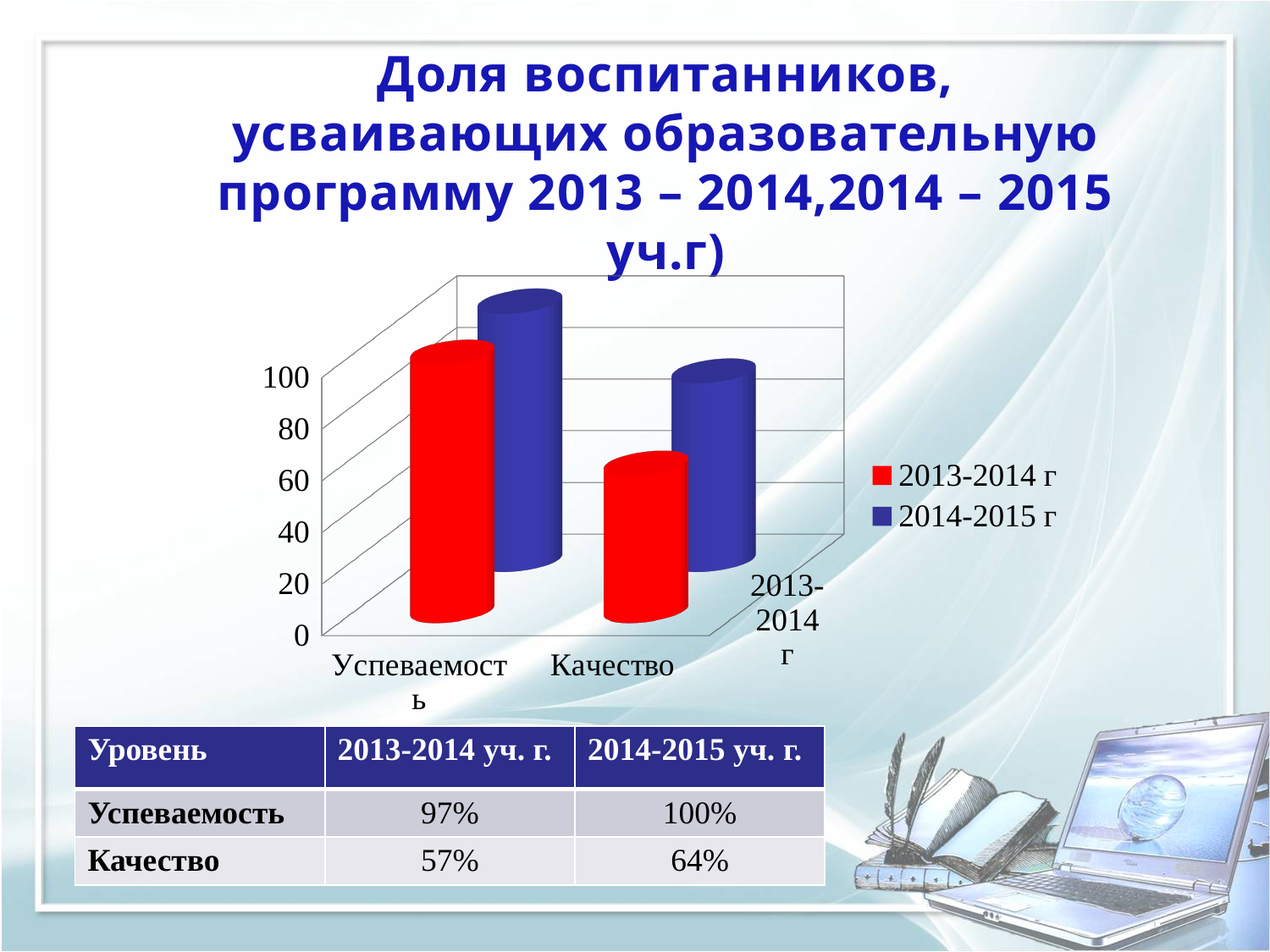
By how much did Качество increase from 2013-2014 to 2014-2015? 7% How many series does the chart legend list? 2 What is the value for Успеваемость in 2014-2015 according to the table below the chart? 100% How many categories are shown on the x axis of the chart? 2 What kind of chart is shown on the slide? bar chart What is the value for Успеваемость in 2013-2014 according to the table below the chart? 97% What is the value for Качество in 2014-2015 according to the table below the chart? 64% Which category has the highest value in the 2014-2015 series? Успеваемость What is the value for Качество in 2013-2014 according to the table below the chart? 57% Which category has the lowest value in the 2013-2014 series? Качество Which colour represents the 2014-2015 г series in the chart? blue Which is larger: Успеваемость in 2013-2014 or Успеваемость in 2014-2015? 2014-2015